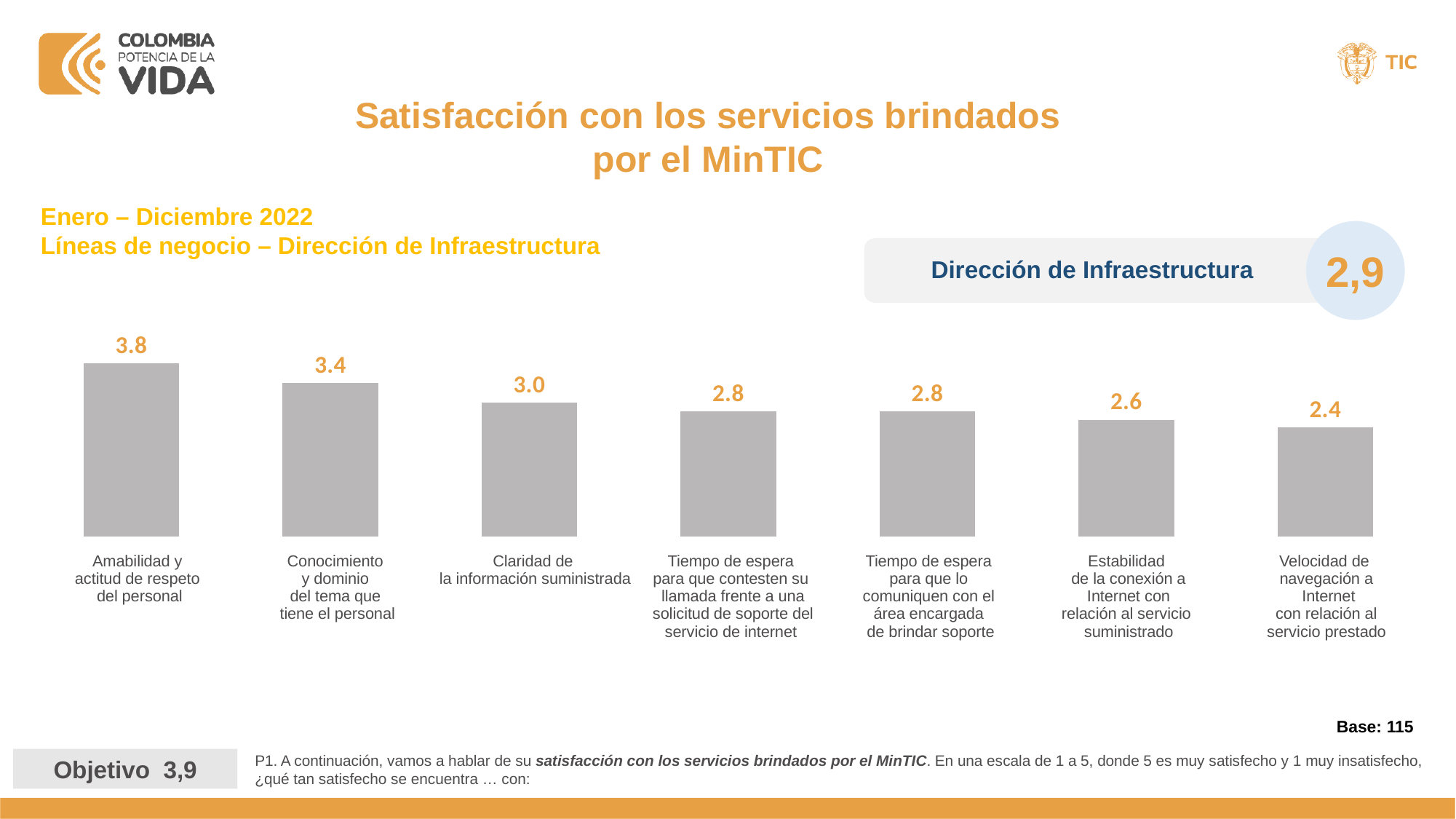
What is the difference between the values for "Amabilidad y actitud de respeto del personal" and "Conocimiento y dominio del tema que tiene el personal"? 0.4 Which category has the highest value? Amabilidad y actitud de respeto del personal What is the value for "Claridad de la información suministrada"? 3.0 What is the value for "Velocidad de navegación a Internet con relación al servicio prestado"? 2.4 Which is larger: the value for "Claridad de la información suministrada" or the value for "Estabilidad de la conexión a Internet con relación al servicio suministrado"? Claridad de la información suministrada What kind of chart is shown on the slide? Bar chart What is the value for "Estabilidad de la conexión a Internet con relación al servicio suministrado"? 2.6 Do the values rise or fall from left to right across the chart? Fall What overall score is shown for Dirección de Infraestructura in the circle next to the chart? 2,9 What is the value for "Amabilidad y actitud de respeto del personal"? 3.8 How many categories are shown in the chart? 7 Which category has the lowest value? Velocidad de navegación a Internet con relación al servicio prestado